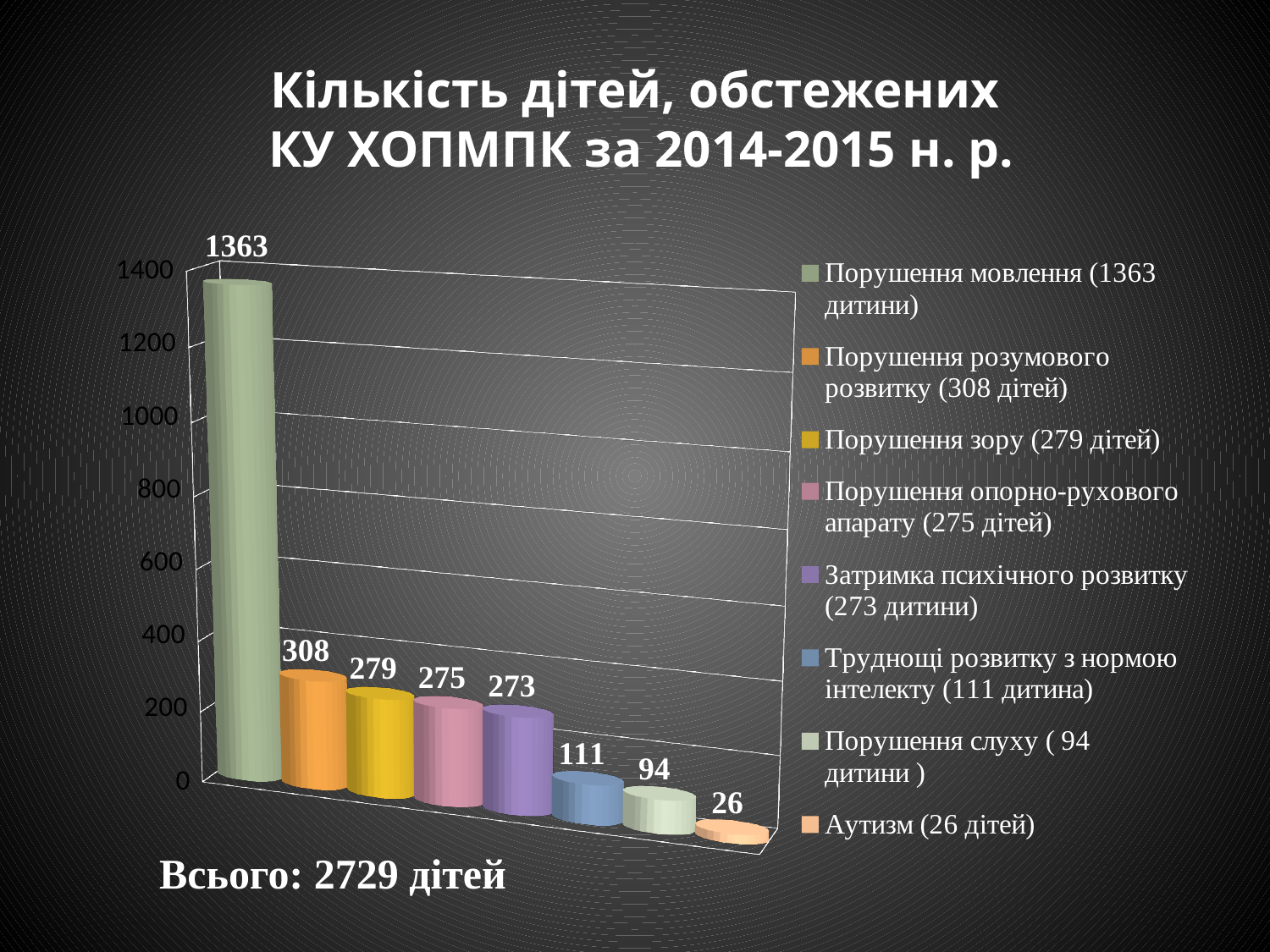
How many categories are plotted in the chart? 8 What value is shown for Порушення мовлення? 1363 What is the difference between the values for Порушення мовлення and Порушення розумового розвитку? 1055 Which category has the lowest value? Аутизм What value is shown for Порушення розумового розвитку? 308 What is the difference between the values for Порушення слуху and Аутизм? 68 What kind of chart is shown on the slide? Bar chart What value is shown for Аутизм? 26 Which category has the highest value? Порушення мовлення What total number of children is stated below the chart? 2729 дітей What value is shown for Труднощі розвитку з нормою інтелекту? 111 Which is larger, the value for Порушення зору or the value for Затримка психічного розвитку? Порушення зору